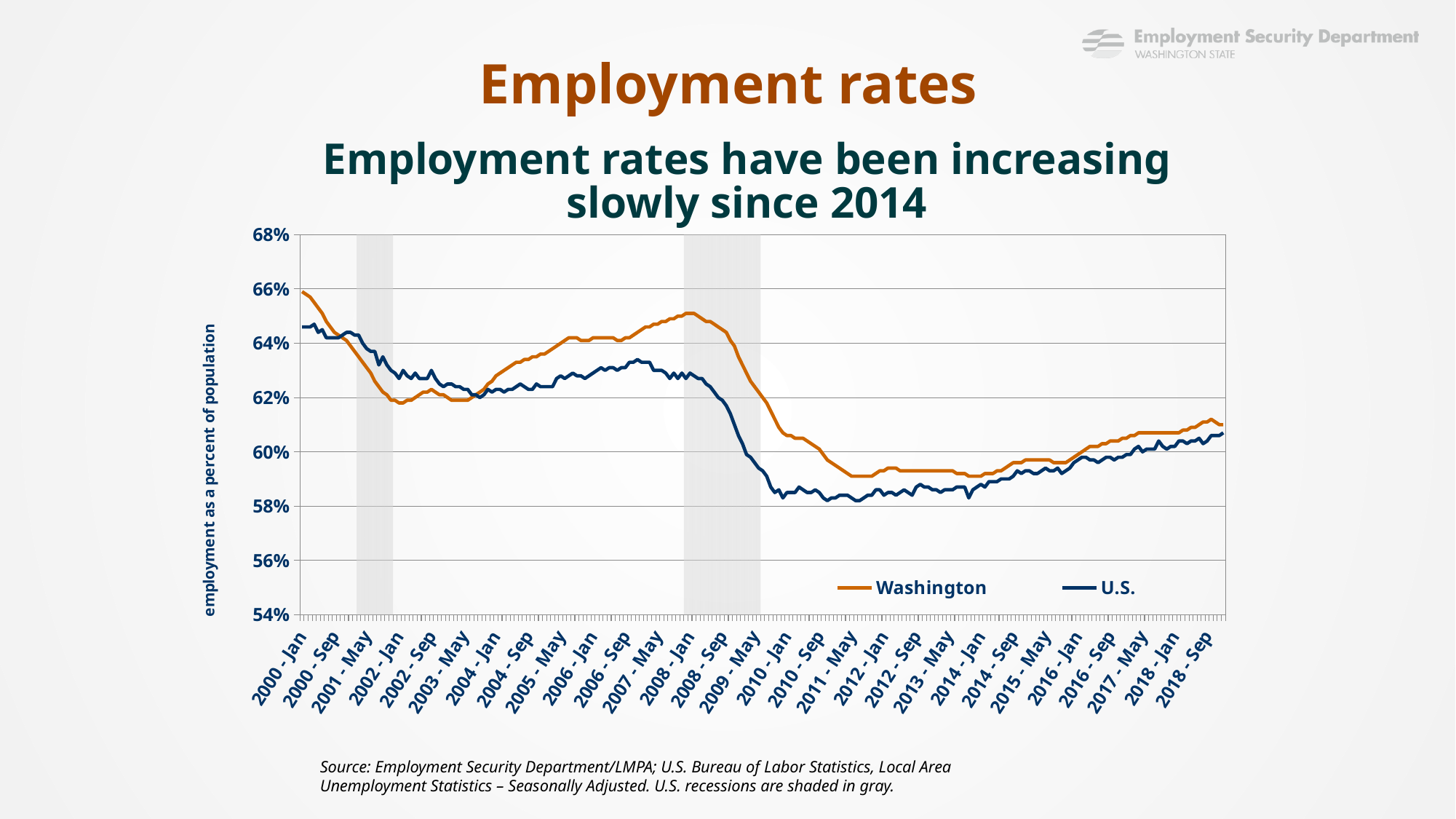
Is the value for U.S. at 2011 - May greater or less than 60%? less Is the value for Washington at 2012 - Jan greater or less than 60%? less Does the Washington line rise or fall between 2008 - Jan and 2010 - Jan? fall Is the value for U.S. at 2018 - Sep greater or less than 62%? less At 2008 - Jan, which series has the higher value, Washington or U.S.? Washington How many series does the legend list? 2 What is the label on the vertical axis? employment as a percent of population What are the two series named in the legend? Washington and U.S. What kind of chart is shown on the slide? line chart Which series reaches the highest value anywhere on the chart? Washington At 2002 - Jan, which series has the higher value, Washington or U.S.? U.S.